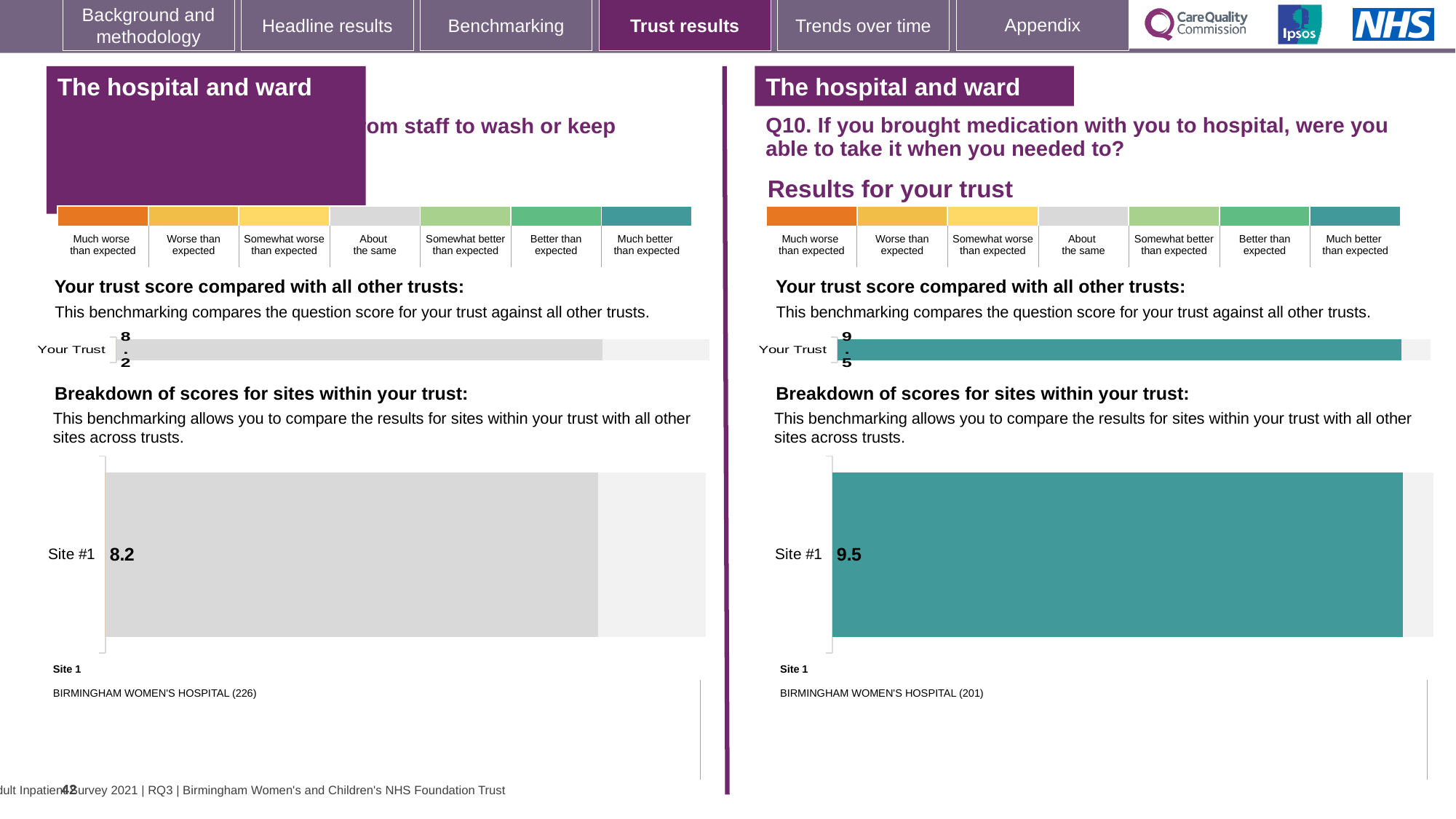
Which is larger: the Your Trust score on the left-hand chart or the Your Trust score on the right-hand Q10 chart? the right-hand Q10 chart (9.5) On the right-hand Q10 chart, which benchmark category does the teal colour of the Your Trust bar correspond to? Much better than expected On the left-hand chart, what is the score shown for Your Trust? 8.2 How many sites are listed in the right-hand breakdown chart for Q10? 1 On the left-hand chart, which benchmark category does the grey colour of the Site #1 bar correspond to? About the same What kind of chart is used to show the Site #1 score on the right-hand side of the slide? bar chart On the left-hand chart, is the Site #1 score greater or less than 9? less What is the difference between the Site #1 score on the right-hand Q10 chart and the Site #1 score on the left-hand chart? 1.3 On the right-hand breakdown chart for Q10, what is the score for Site #1? 9.5 On the right-hand chart for Q10, what is the score shown for Your Trust? 9.5 On the right-hand Q10 chart, is the Your Trust score greater or less than 9? greater On the left-hand breakdown chart, what is the score for Site #1? 8.2